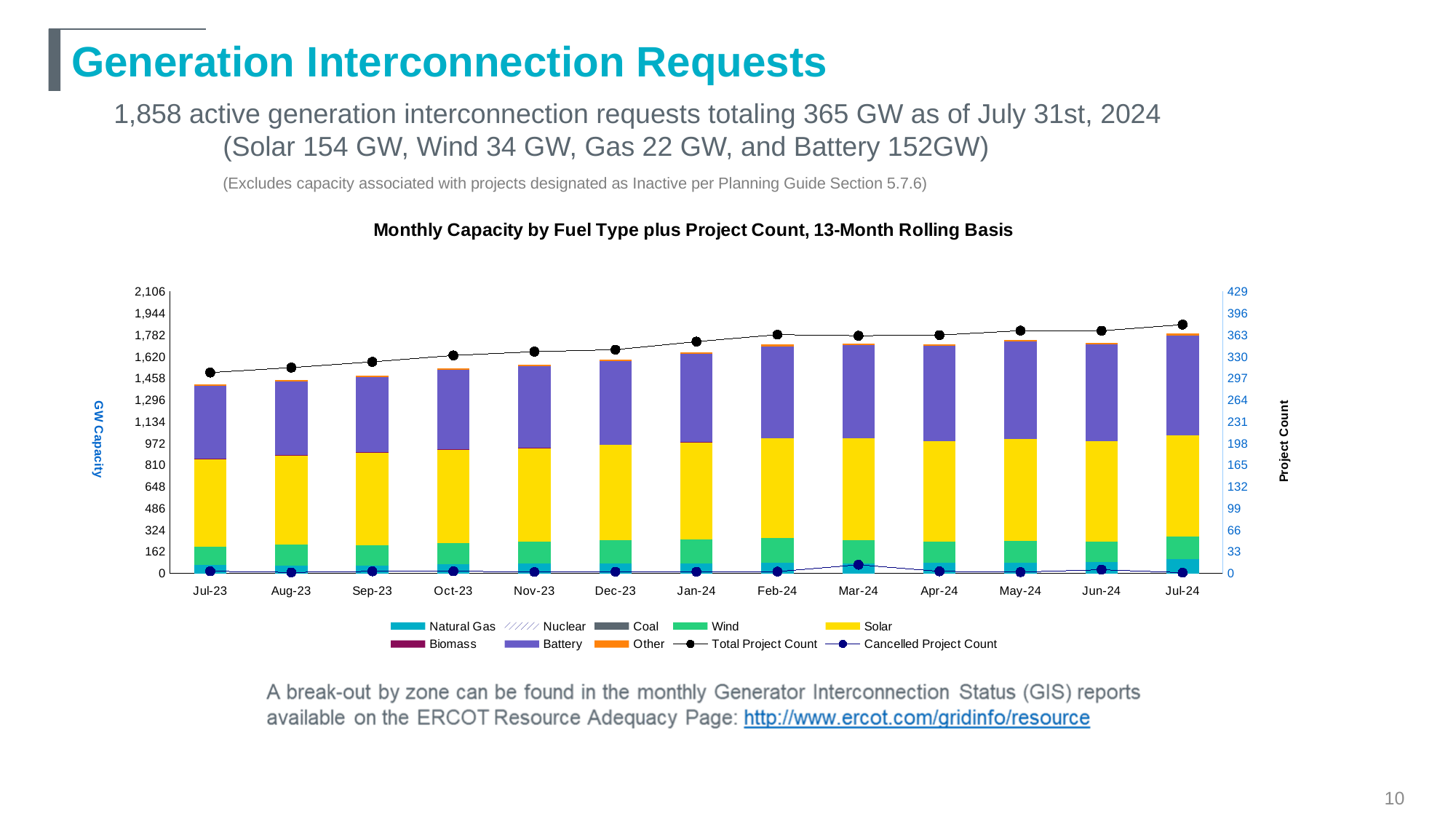
How many series does the chart legend list? 10 What is the label of the right-hand vertical axis? Project Count In Jul-24, which segment is larger: Battery or Wind? Battery What is the title of the chart? Monthly Capacity by Fuel Type plus Project Count, 13-Month Rolling Basis Which month has the shortest stacked bar (lowest total GW capacity)? Jul-23 Which month has the tallest stacked bar (highest total GW capacity)? Jul-24 Does the Total Project Count line rise or fall from Jul-23 to Jul-24? Rise How many months are shown on the x axis of the chart? 13 What type of chart is shown on the slide? Stacked bar chart with line series In which month does the Cancelled Project Count line reach its highest point? Mar-24